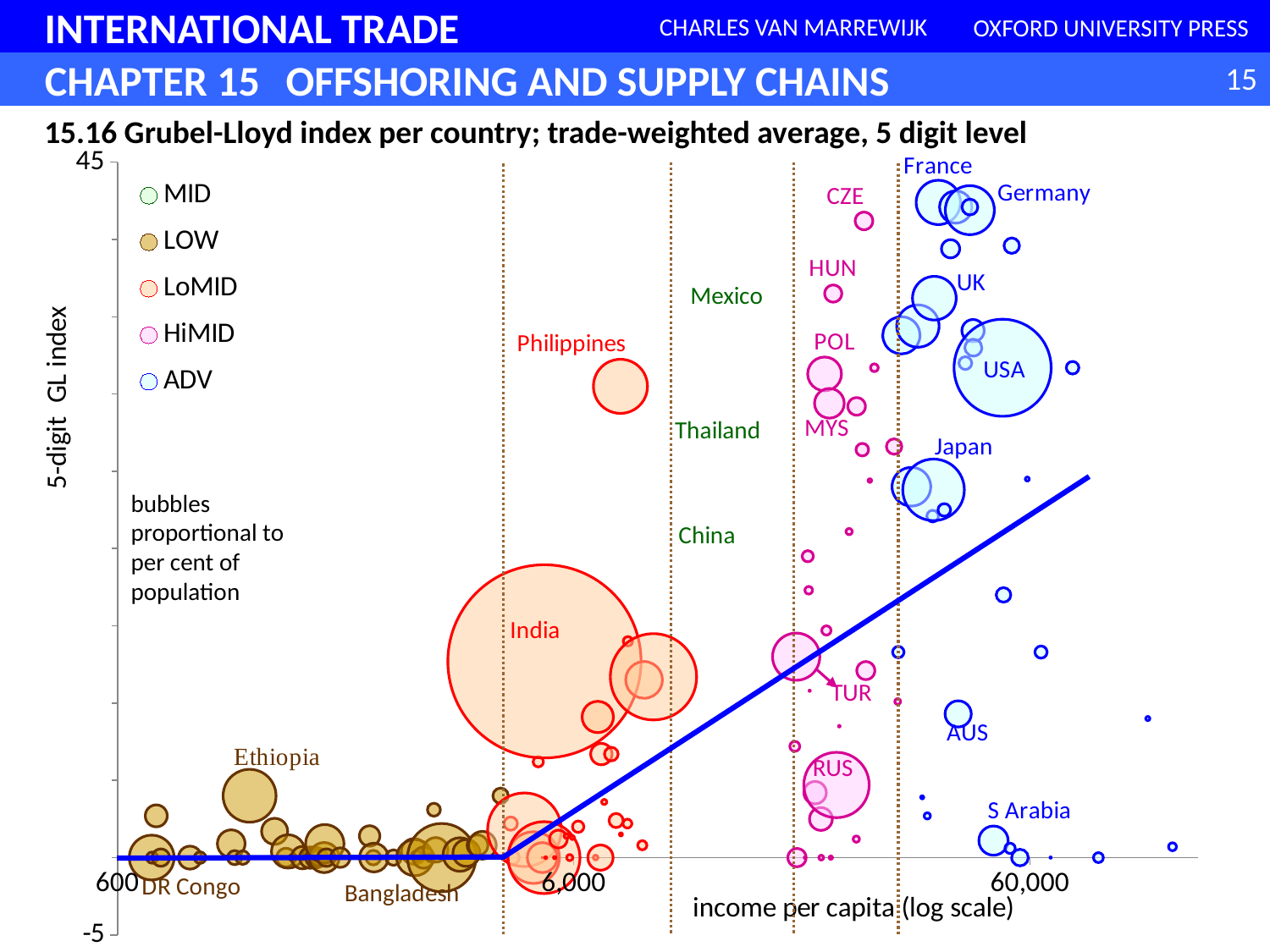
What is the title of the chart? 15.16 Grubel-Lloyd index per country; trade-weighted average, 5 digit level Which has the higher 5-digit GL index, Germany or S Arabia? Germany Which has the higher 5-digit GL index, Ethiopia or DR Congo? Ethiopia Is the income per capita for Ethiopia greater or less than 6,000? less Which has the higher 5-digit GL index, Philippines or India? Philippines How many categories does the legend list? 5 What are the bubble sizes proportional to, according to the chart? per cent of population What kind of chart is shown on the slide? bubble chart Does the fitted trend line rise or fall as income per capita increases beyond 6,000? rise